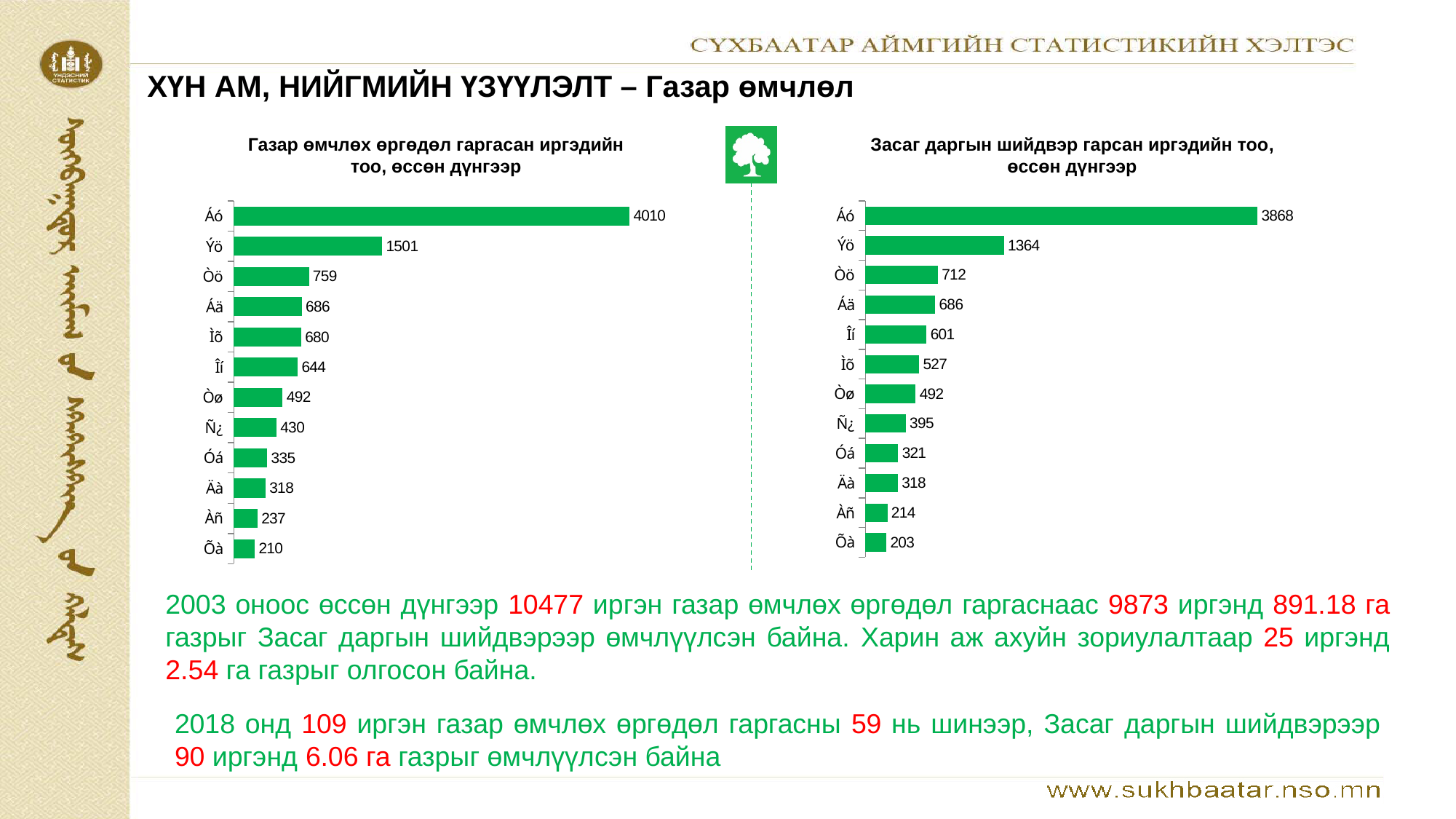
In the right chart, what is the value for the bottom bar labelled Õà? 203 What is the title of the right chart? Засаг даргын шийдвэр гарсан иргэдийн тоо, өссөн дүнгээр In the left chart (Газар өмчлөх өргөдөл гаргасан иргэдийн тоо), what is the value for the top bar labelled Áó? 4010 In the right chart, which category has the highest value? Áó In the left chart, which category has the lowest value? Õà In the left chart, what is the difference between the values for Áó and Ýö? 2509 In the right chart, what is the difference between the values for Òö and Áä? 26 In the left chart, which is larger, the value for Òö or the value for Òø? Òö In the left chart, what is the value for Ñ¿? 430 In the right chart (Засаг даргын шийдвэр гарсан иргэдийн тоо), what is the value for Ýö? 1364 How many categories are shown in the right chart? 12 What kind of chart is the left chart? Bar chart